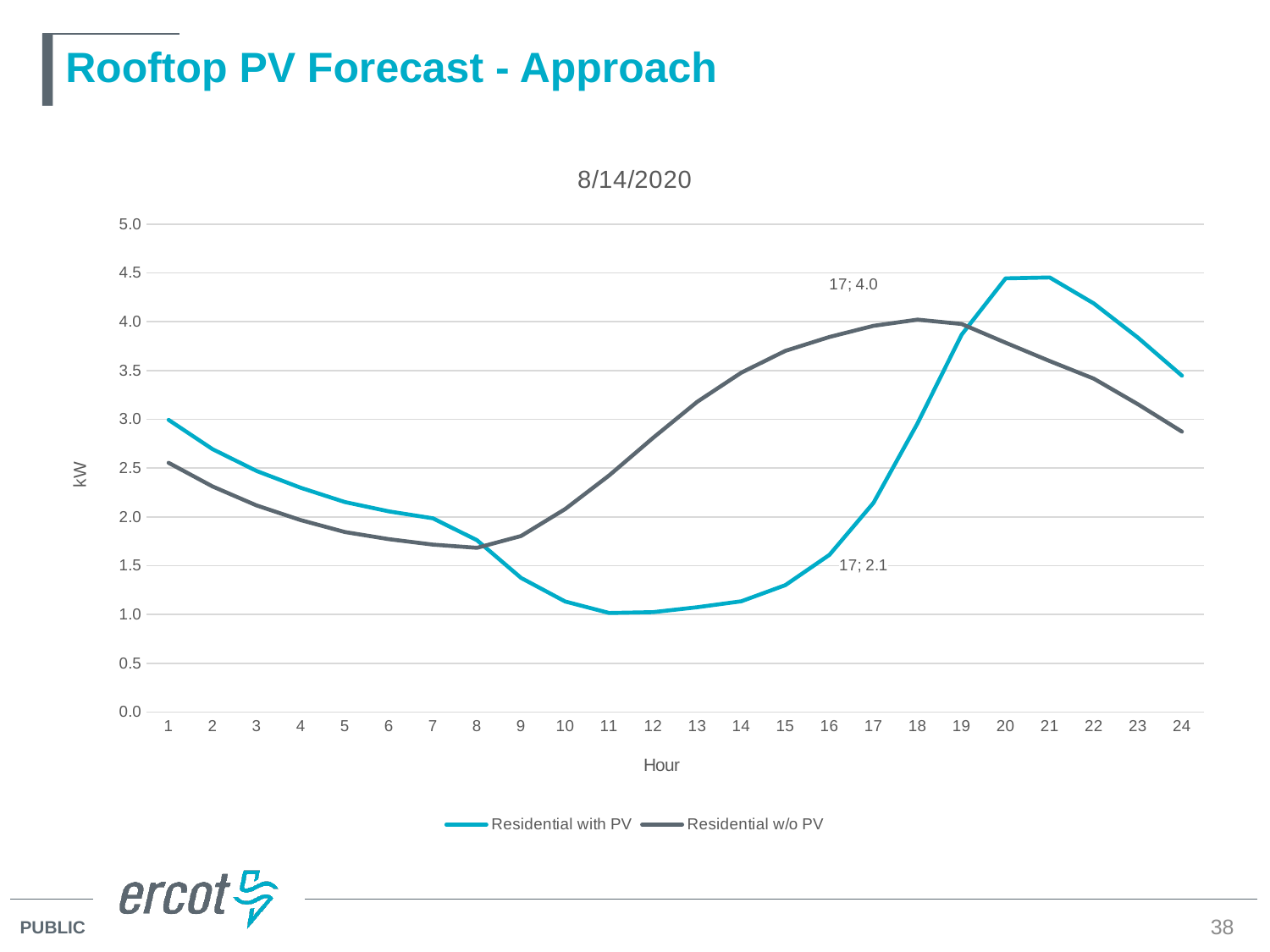
How many series does the legend list? 2 What is the difference between Residential w/o PV and Residential with PV at hour 17? 1.9 What kind of chart is shown on the slide? line chart Is the value for Residential with PV at hour 11 greater or less than 1.5? less At hour 17, which series has the larger value? Residential w/o PV What is the title of the chart? 8/14/2020 What is the value for Residential with PV at hour 17? 2.1 How many hours are plotted along the x axis? 24 At hour 1, which series has the larger value? Residential with PV What is the value for Residential w/o PV at hour 17? 4.0 Does the Residential with PV line rise or fall from hour 1 to hour 11? fall Is the value for Residential with PV at hour 20 greater or less than 4.0? greater